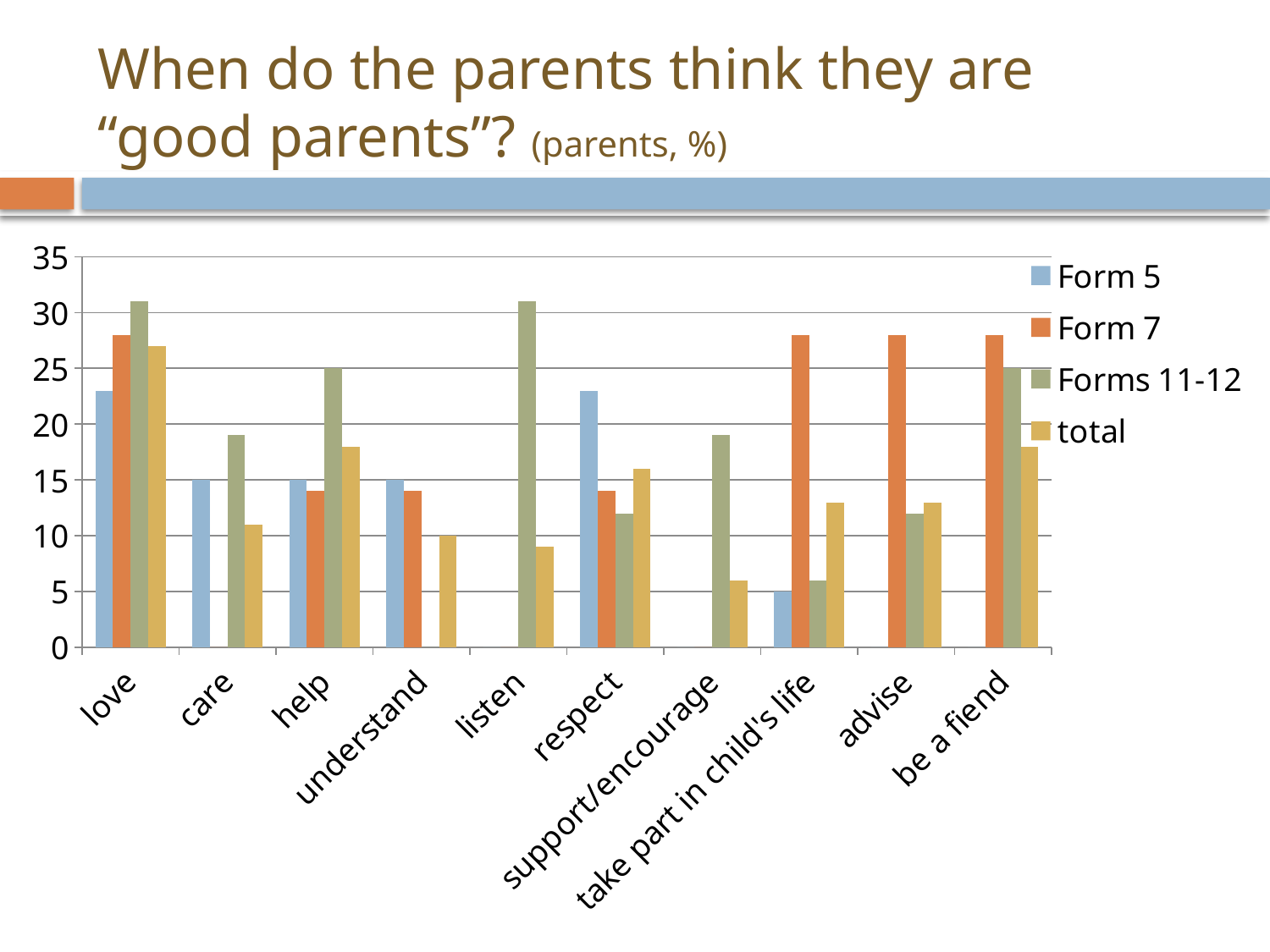
What kind of chart is shown on the slide? bar chart What is the difference between the Forms 11-12 value and the Form 5 value for "help"? 10 What is the Form 5 value for "care"? 15 Which category has the highest total value? love How many series does the legend list? 4 For "love", which is larger: the Form 5 value or the Form 7 value? Form 7 What is the Form 5 value for "take part in child's life"? 5 Which category has the lowest Form 5 value among those with a Form 5 bar? take part in child's life Is the total value for "support/encourage" greater or less than 10? less What is the Forms 11-12 value for "help"? 25 How many categories are shown on the x axis? 10 Is the Forms 11-12 value for "listen" greater or less than 30? greater